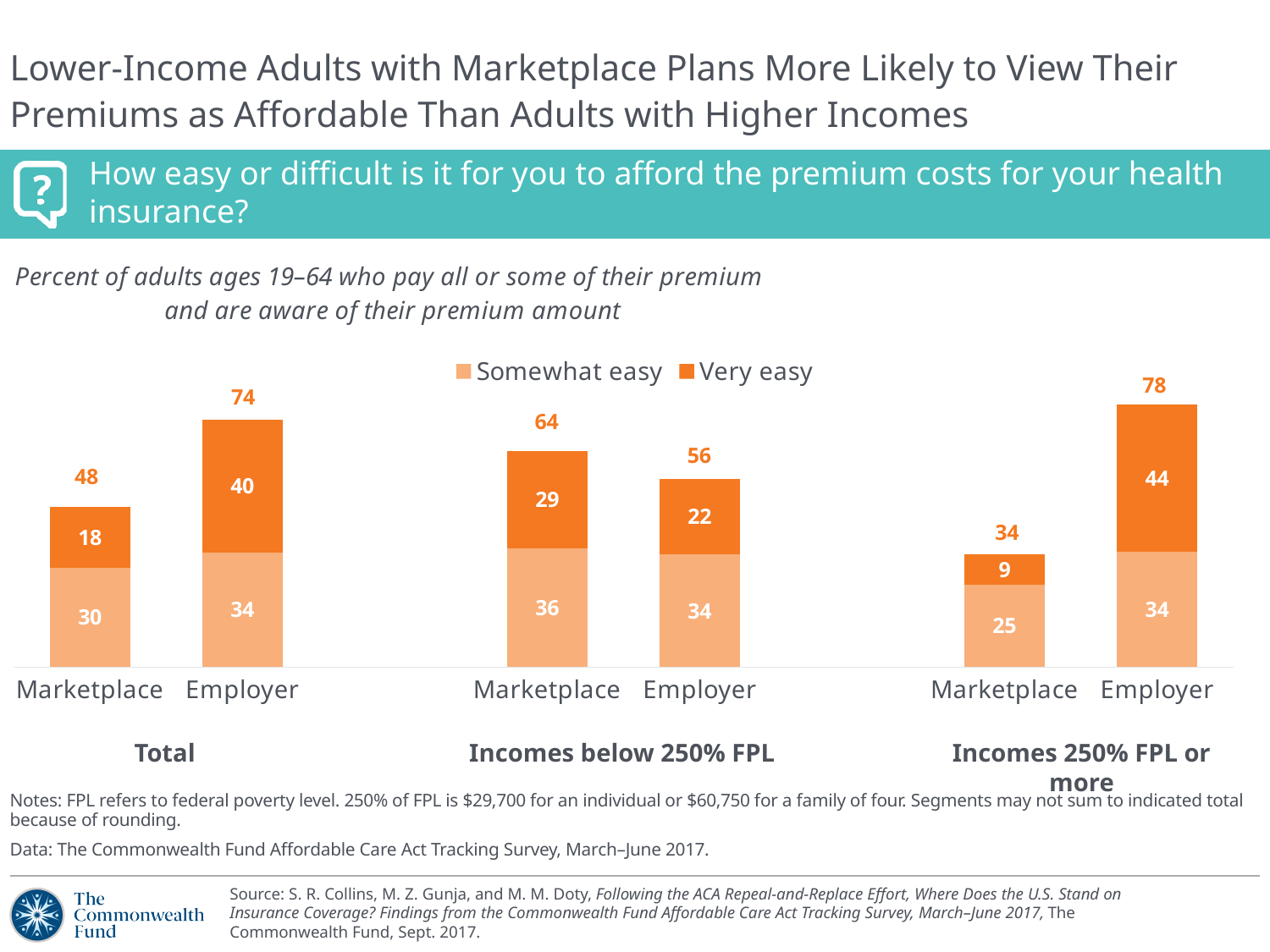
In the Incomes below 250% FPL chart, what is the Very easy value for Marketplace? 29 In the Incomes below 250% FPL chart, which bar has the higher total, Marketplace or Employer? Marketplace What kind of chart is used on this slide? Stacked bar chart In the Incomes 250% FPL or more chart, what is the total printed above the Employer bar? 78 In the Incomes 250% FPL or more chart, what is the Somewhat easy value for Marketplace? 25 In the Total chart, what is the Somewhat easy value for Marketplace? 30 In the Total chart, what is the difference between the Employer total and the Marketplace total? 26 In the Incomes below 250% FPL chart, what is the total printed above the Marketplace bar? 64 In the Total chart, what is the Very easy value for Employer? 40 How many series does the legend list? 2 What are the two series named in the legend? Somewhat easy and Very easy In the Incomes 250% FPL or more chart, which bar has the lowest total? Marketplace